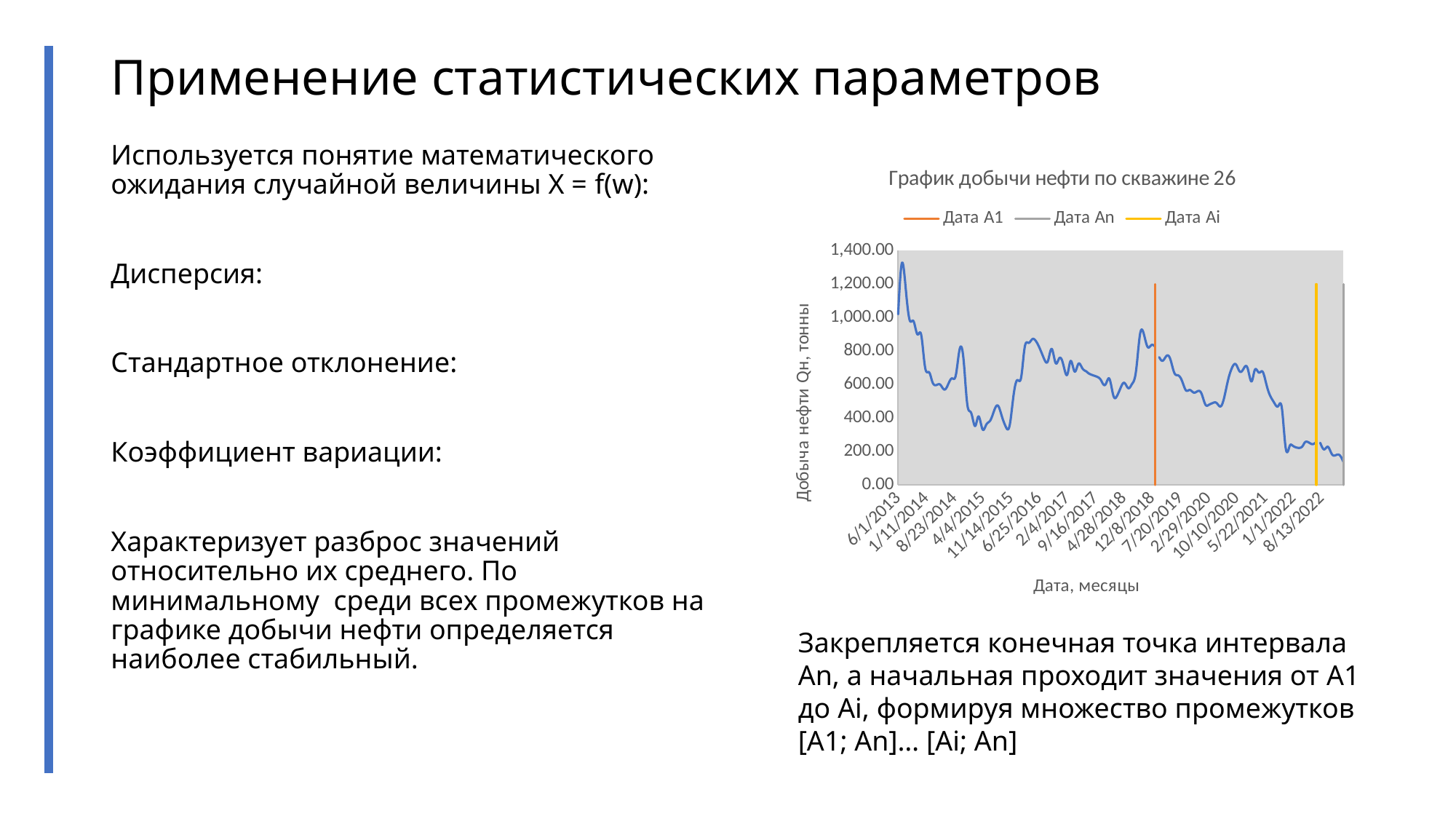
Overall, does the oil production line rise or fall from the left of the x axis to the right? fall What is the highest tick value shown on the vertical axis? 1,400.00 Is the oil production value at 12/8/2018 greater or less than 600.00? greater How many entries does the chart legend list? 3 Which is larger, the oil production value at 6/1/2013 or at 8/13/2022? 6/1/2013 What kind of chart is shown on the slide? line chart Is the oil production value at 8/13/2022 greater or less than 400.00? less What is the title of the chart? График добычи нефти по скважине 26 What is the first date label shown on the horizontal axis? 6/1/2013 What is the label of the vertical axis of the chart? Добыча нефти Qн, тонны Is the oil production value around 4/4/2015 greater or less than 600.00? less